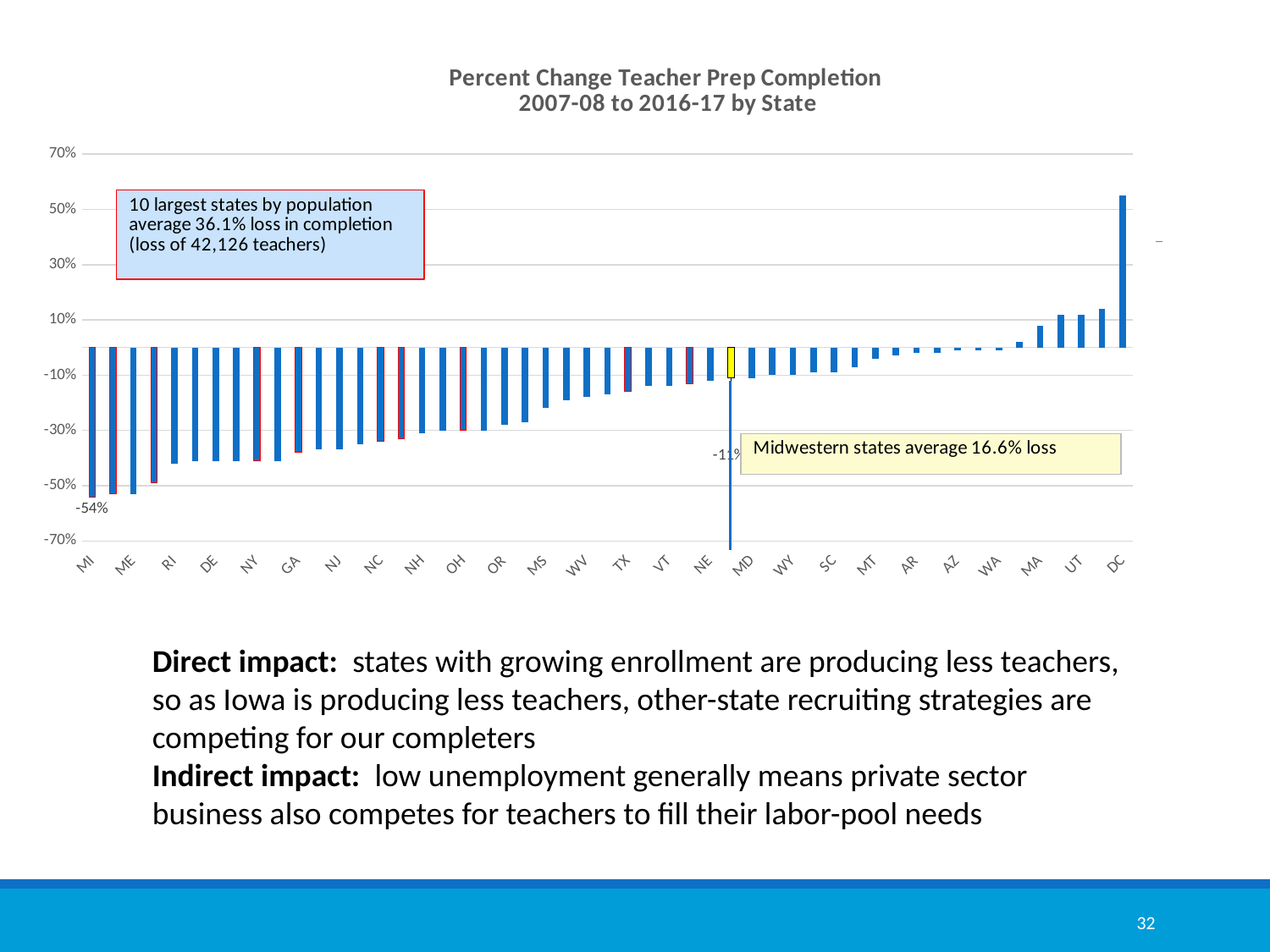
Which has the larger percent change, MI or DC? DC Do the values generally rise or fall moving from left to right along the x axis? rise According to the annotation on the chart, what is the average loss in completion for the 10 largest states by population? 36.1% Is the value for NY greater or less than -30%? less Which state has the lowest percent change in teacher prep completion? MI Which has the larger percent change, ME or OH? OH What is the title of the chart? Percent Change Teacher Prep Completion 2007-08 to 2016-17 by State What kind of chart is shown on the slide? bar chart Is the value for DC greater or less than 50%? greater What is the percent change in teacher prep completion for MI? -54% Is the value for TX greater or less than -30%? greater Which state has the highest percent change in teacher prep completion? DC